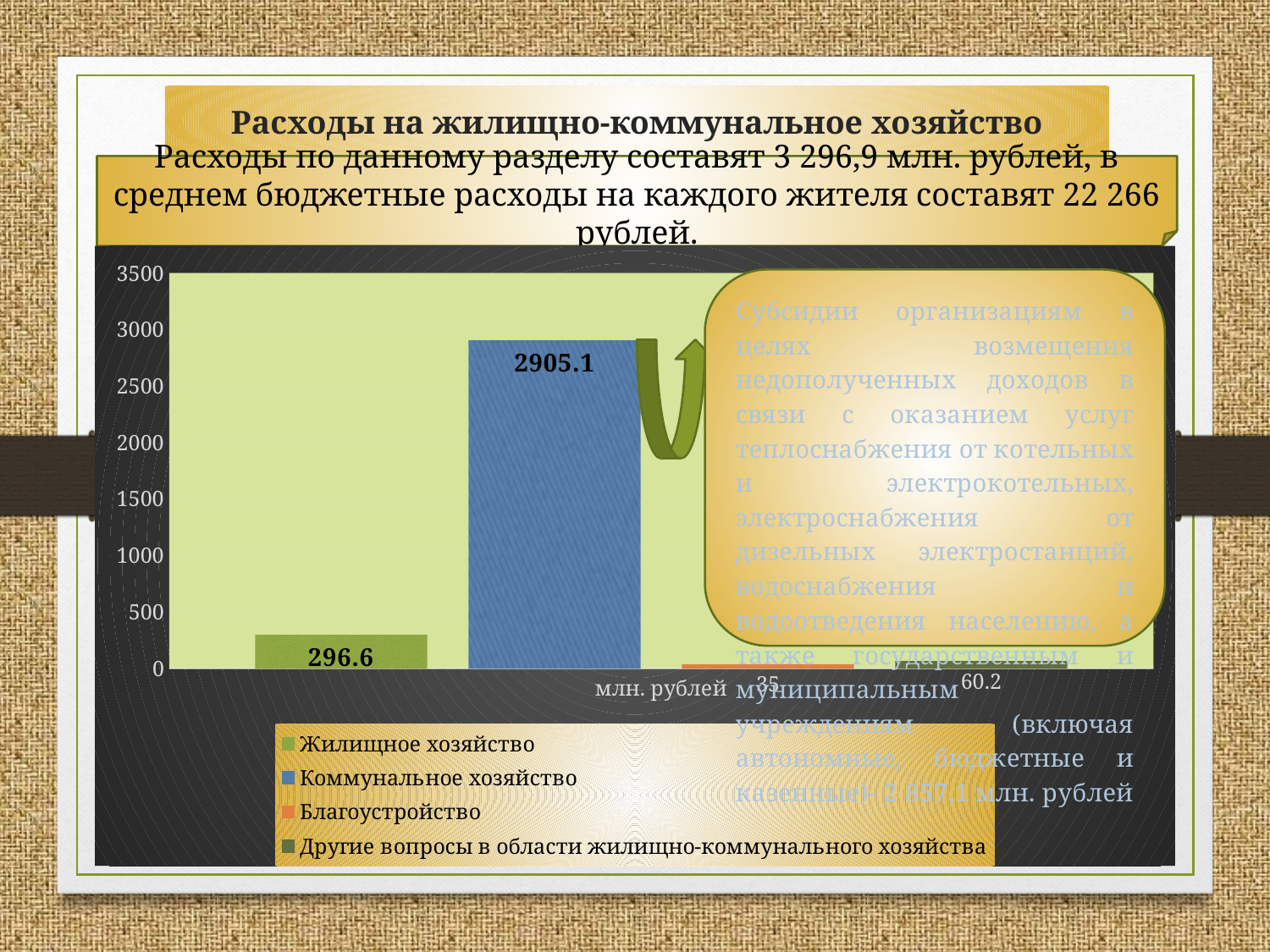
What is the value for Благоустройство? 35 Is the value for Коммунальное хозяйство greater or less than 2500? greater Which category has the highest value? Коммунальное хозяйство What is the value for Другие вопросы в области жилищно-коммунального хозяйства? 60.2 Which category has the lowest value? Благоустройство How many series does the legend list? 4 What is the value for Жилищное хозяйство? 296.6 What is the difference between the values for Коммунальное хозяйство and Жилищное хозяйство? 2608.5 What unit is shown on the chart's axis label? млн. рублей Which is larger, the value for Жилищное хозяйство or the value for Другие вопросы в области жилищно-коммунального хозяйства? Жилищное хозяйство What kind of chart is shown on the slide? bar chart What is the value for Коммунальное хозяйство? 2905.1